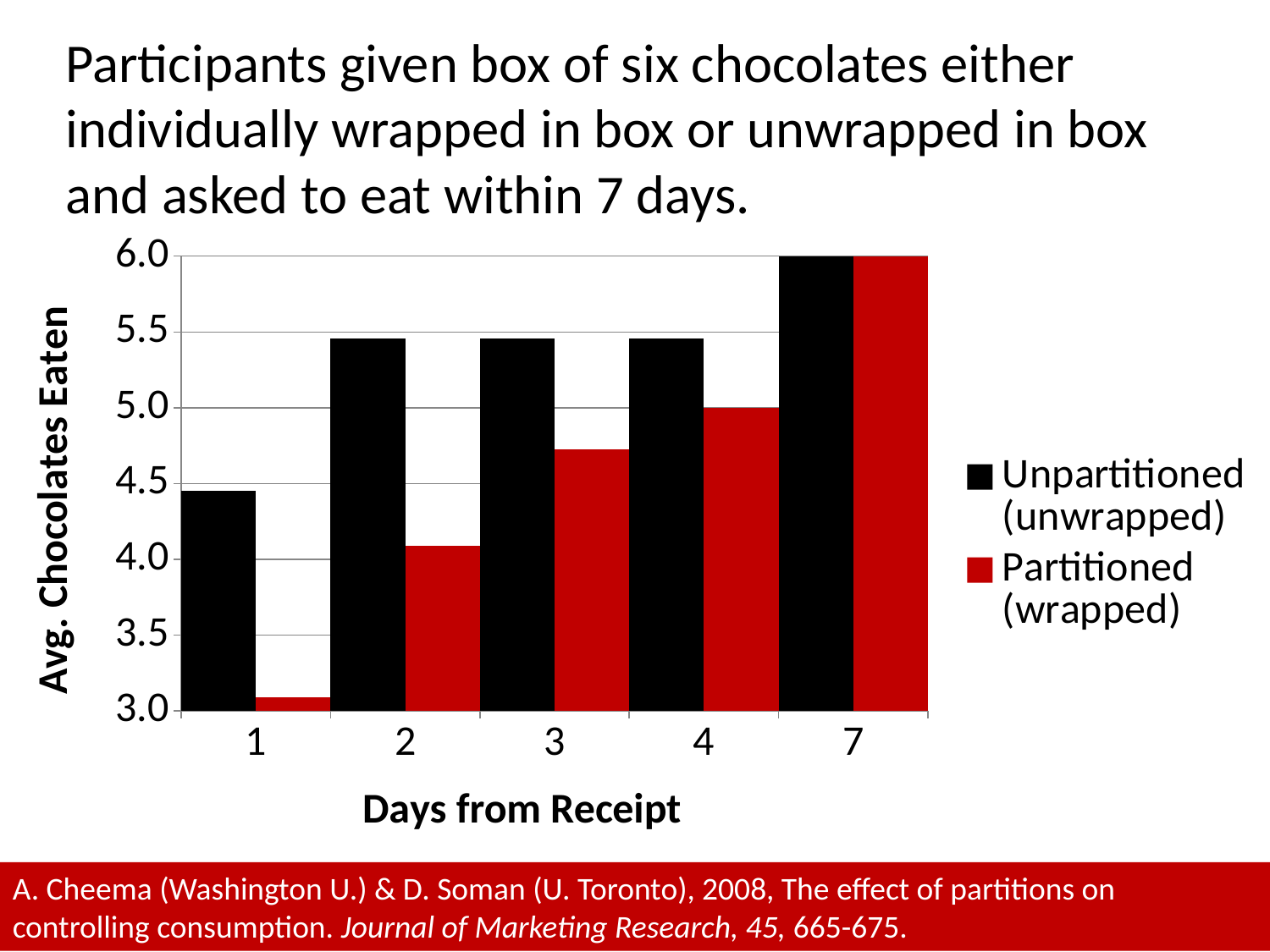
What kind of chart is shown on the slide? bar chart At day 2, which group has the higher average number of chocolates eaten? Unpartitioned (unwrapped) What is the average number of chocolates eaten for the Unpartitioned (unwrapped) group at day 7? 6.0 What is the average number of chocolates eaten for the Partitioned (wrapped) group at day 4? 5.0 How many series does the legend list? 2 For the Partitioned (wrapped) group, which day has the lowest average number of chocolates eaten? 1 What is the title of the x axis? Days from Receipt Is the value for the Partitioned (wrapped) group at day 1 greater or less than 3.5? less Is the value for the Unpartitioned (unwrapped) group at day 2 greater or less than 5.0? greater Do the values for the Partitioned (wrapped) group rise or fall as days from receipt increase? rise For the Partitioned (wrapped) group, which day has the highest average number of chocolates eaten? 7 How many categories (days) are shown on the x axis? 5